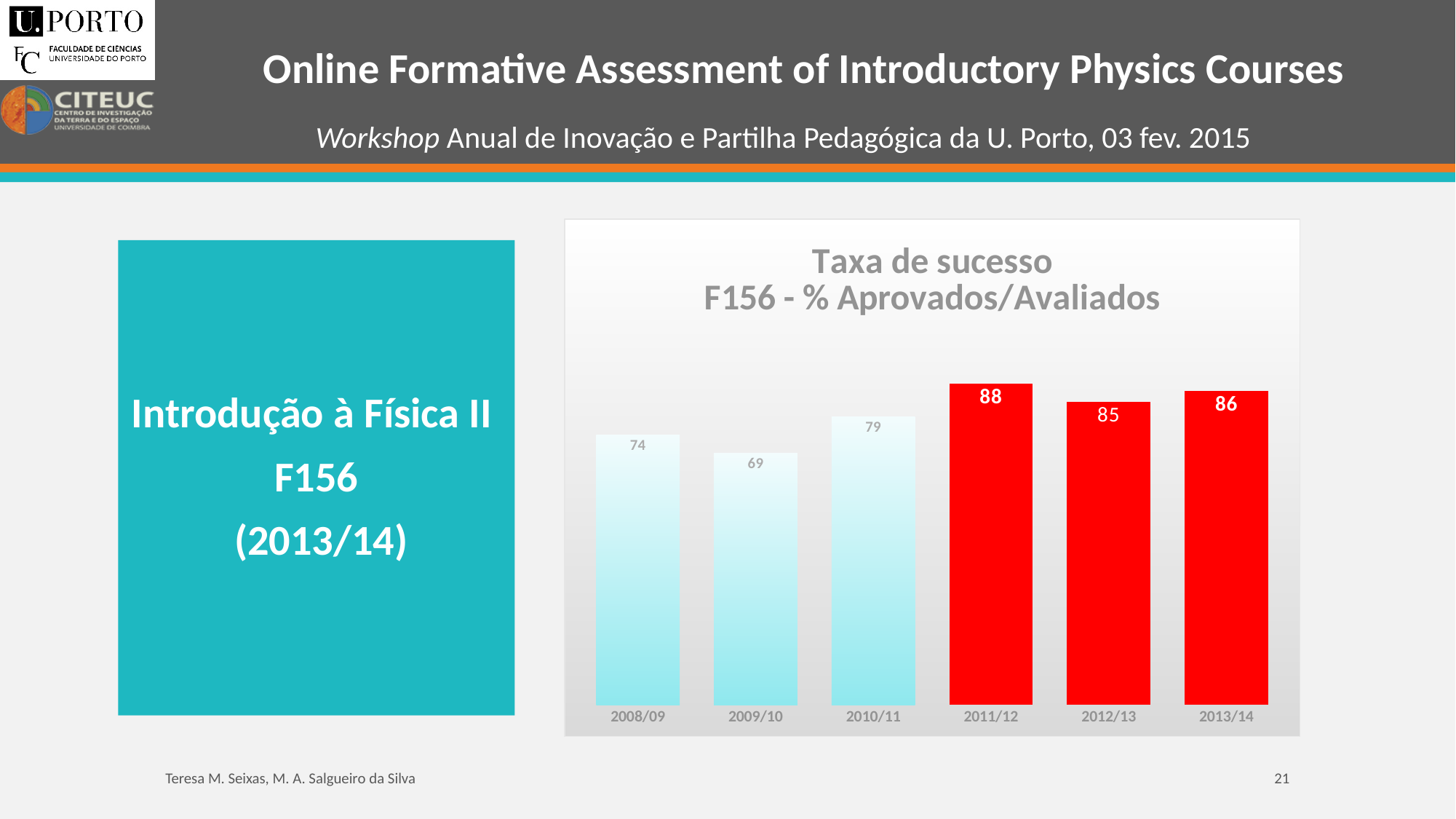
What is the difference between the values for 2010/11 and 2008/09? 5 What is the value for 2008/09? 74 Which year has the highest success rate? 2011/12 Which year has the lowest success rate? 2009/10 Which is larger, the value for 2012/13 or the value for 2013/14? 2013/14 What is the difference between the values for 2011/12 and 2009/10? 19 What is the value for 2013/14? 86 What is the title of the chart? Taxa de sucesso F156 - % Aprovados/Avaliados Which bars are coloured red? 2011/12, 2012/13 and 2013/14 How many academic years are shown on the x axis? 6 What is the value for 2011/12? 88 What kind of chart is this? bar chart